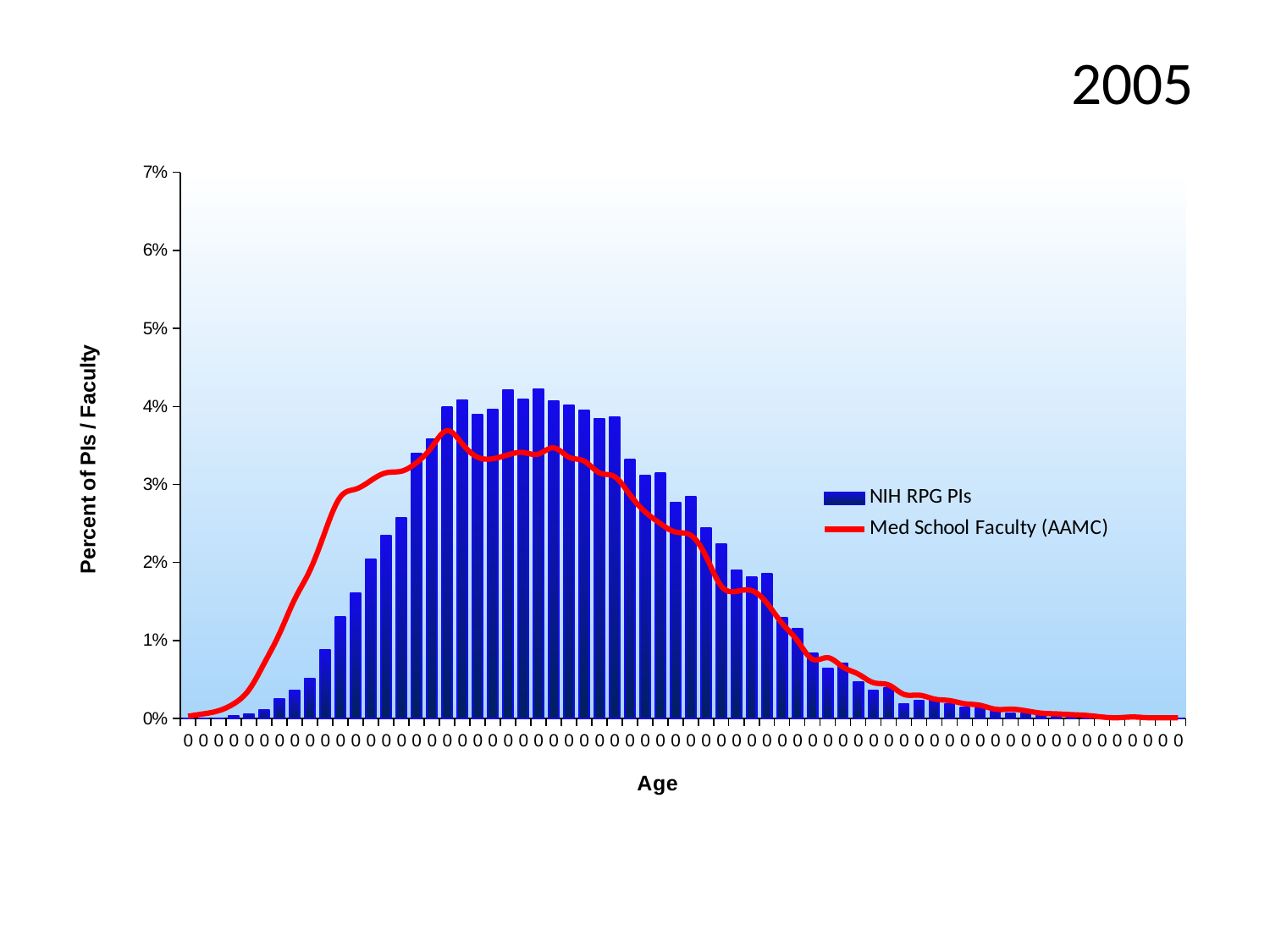
What is the highest value shown on the vertical axis? 7% Is the tallest NIH RPG PIs bar greater or less than 4%? greater How many series does the legend list? 2 Toward the right end of the Age axis, do the NIH RPG PIs bar values rise or fall? fall What kind of chart is shown on the slide? A bar chart with a line overlaid What is the title of the vertical axis? Percent of PIs / Faculty Does any NIH RPG PIs bar reach 5%? No Is the peak of the Med School Faculty (AAMC) line greater or less than 3%? greater Which series is drawn as bars and which as a line? NIH RPG PIs is bars; Med School Faculty (AAMC) is the line At the far left of the Age axis, do the Med School Faculty (AAMC) values rise or fall as age increases? rise